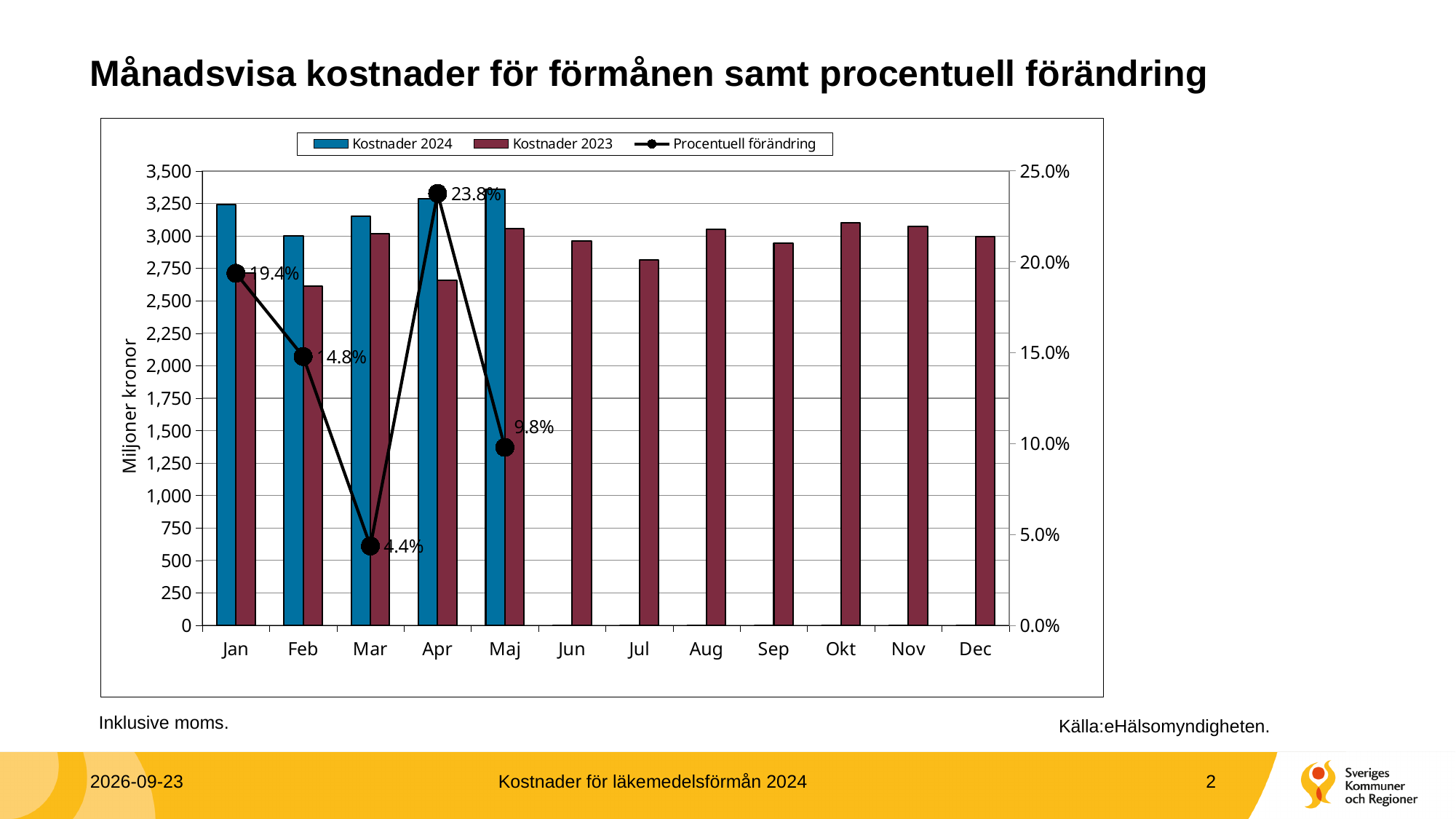
Which month has the highest Procentuell förändring? Apr How many series does the legend list? 3 What is the Procentuell förändring value for Jan? 19.4% What is the label of the left vertical axis? Miljoner kronor Which month has the larger Procentuell förändring, Jan or Feb? Jan Which month has the lowest Procentuell förändring? Mar Is the Kostnader 2023 value for Feb greater or less than 2,750? less What is the Procentuell förändring value for Mar? 4.4% Is the Kostnader 2024 value for Jan greater or less than 3,000? greater What is the difference between the Procentuell förändring for Apr and for Mar? 19.4 percentage points What is the Procentuell förändring value for Apr? 23.8% How many months are shown on the x axis? 12